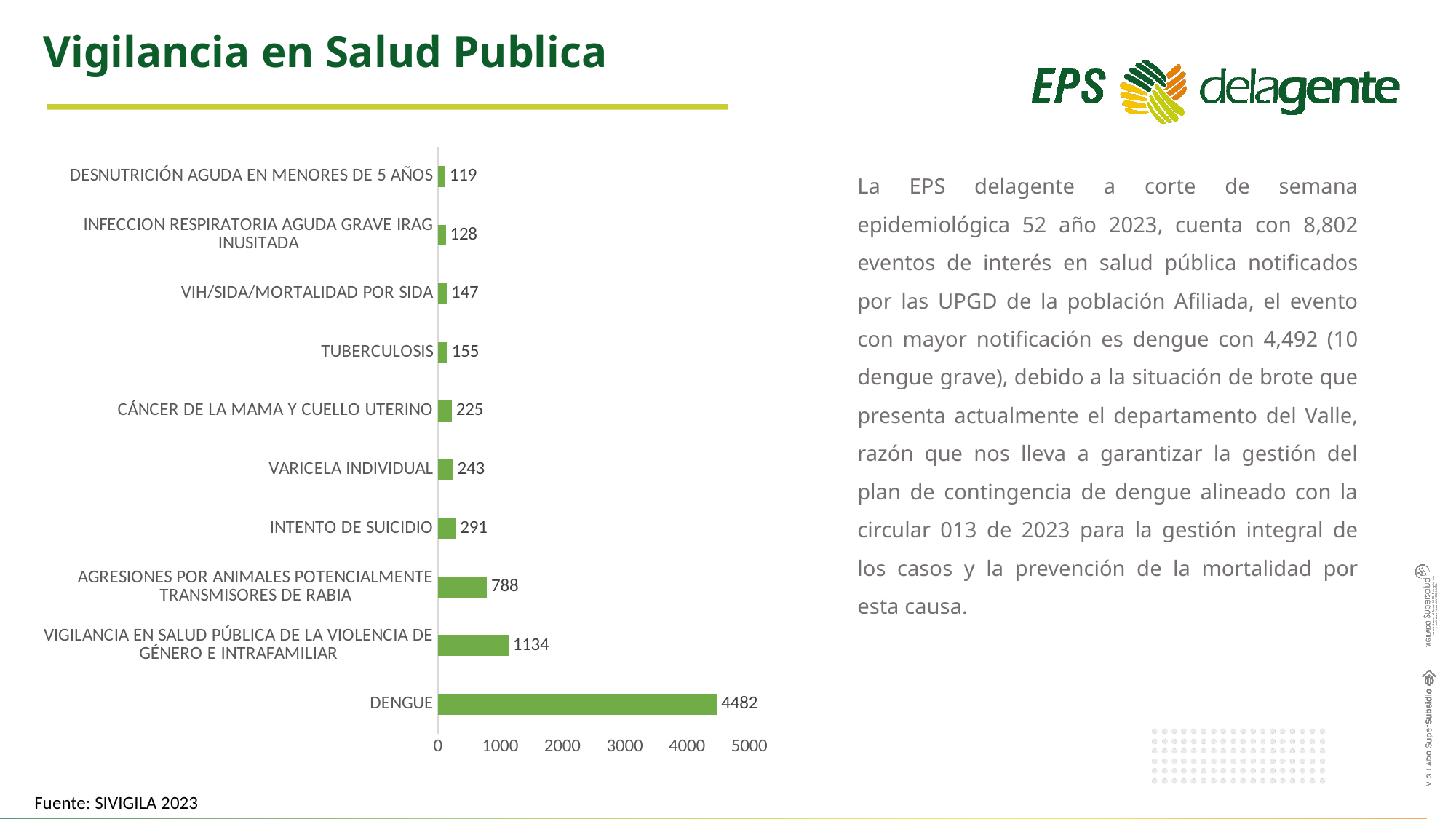
Is the value for DENGUE greater or less than 4000? greater How many categories are shown in the chart? 10 What is the difference between the values for INTENTO DE SUICIDIO and CÁNCER DE LA MAMA Y CUELLO UTERINO? 66 Which category has the highest value? DENGUE What is the value for DENGUE? 4482 What kind of chart is shown on the slide? bar chart What is the difference between the values for DENGUE and VIGILANCIA EN SALUD PÚBLICA DE LA VIOLENCIA DE GÉNERO E INTRAFAMILIAR? 3348 What is the value for AGRESIONES POR ANIMALES POTENCIALMENTE TRANSMISORES DE RABIA? 788 Which category has the lowest value? DESNUTRICIÓN AGUDA EN MENORES DE 5 AÑOS What is the value for TUBERCULOSIS? 155 Which is larger, the value for VIH/SIDA/MORTALIDAD POR SIDA or the value for INFECCION RESPIRATORIA AGUDA GRAVE IRAG INUSITADA? VIH/SIDA/MORTALIDAD POR SIDA What is the value for VARICELA INDIVIDUAL? 243